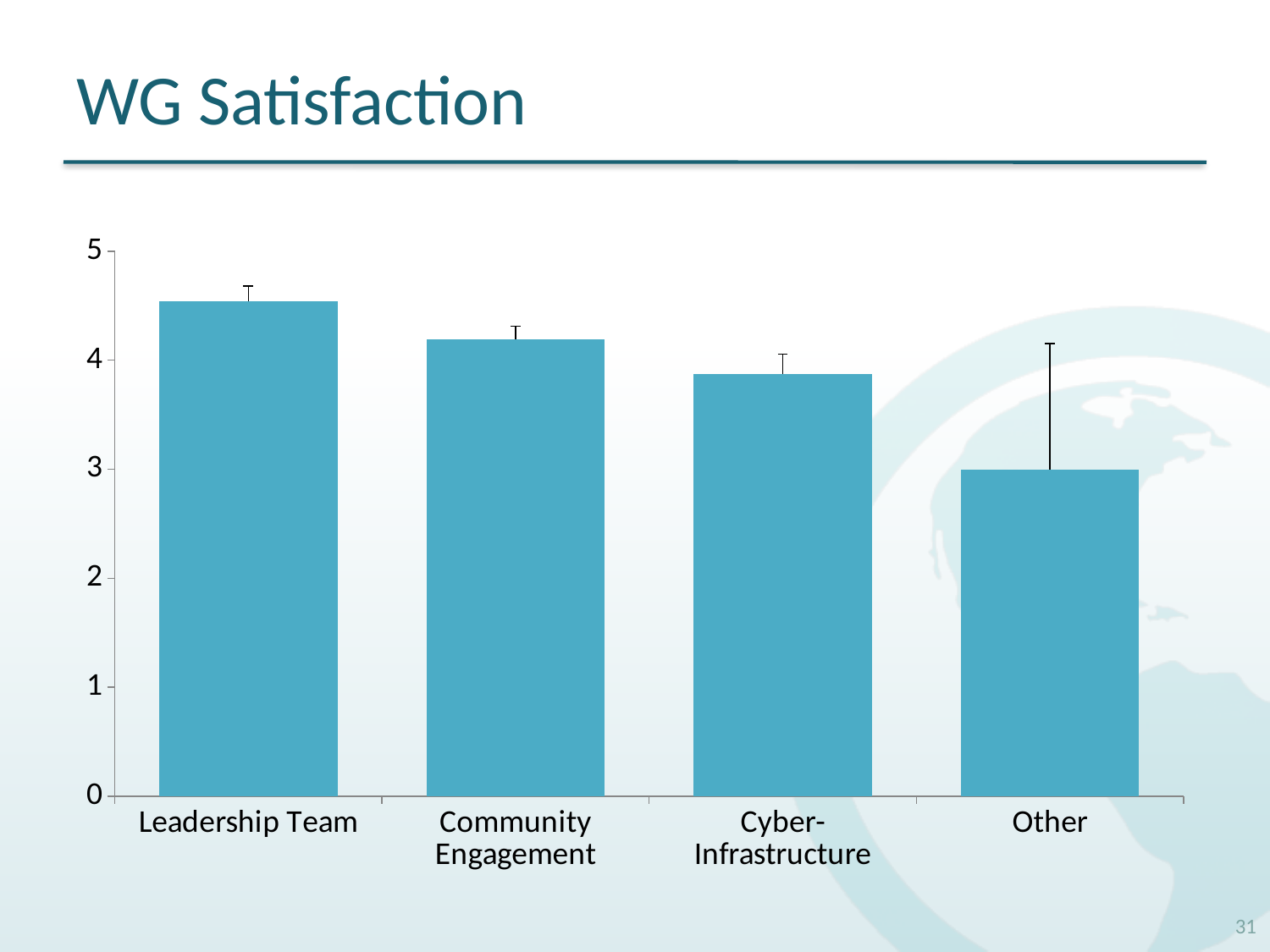
Which is larger, the value for Community Engagement or the value for Cyber-Infrastructure? Community Engagement Is the value for Cyber-Infrastructure greater or less than 4? less What kind of chart is shown on the slide? bar chart Is the value for Leadership Team greater or less than 4? greater Is the value for Community Engagement greater or less than 4? greater Which category has the lowest satisfaction value? Other Which category has the highest satisfaction value? Leadership Team How many categories are shown on the x axis of the chart? 4 Which is larger, the value for Leadership Team or the value for Other? Leadership Team Which category has the longest error bar on its bar? Other Do the bar values rise or fall moving from left to right across the categories? fall What is the title of the slide containing the chart? WG Satisfaction